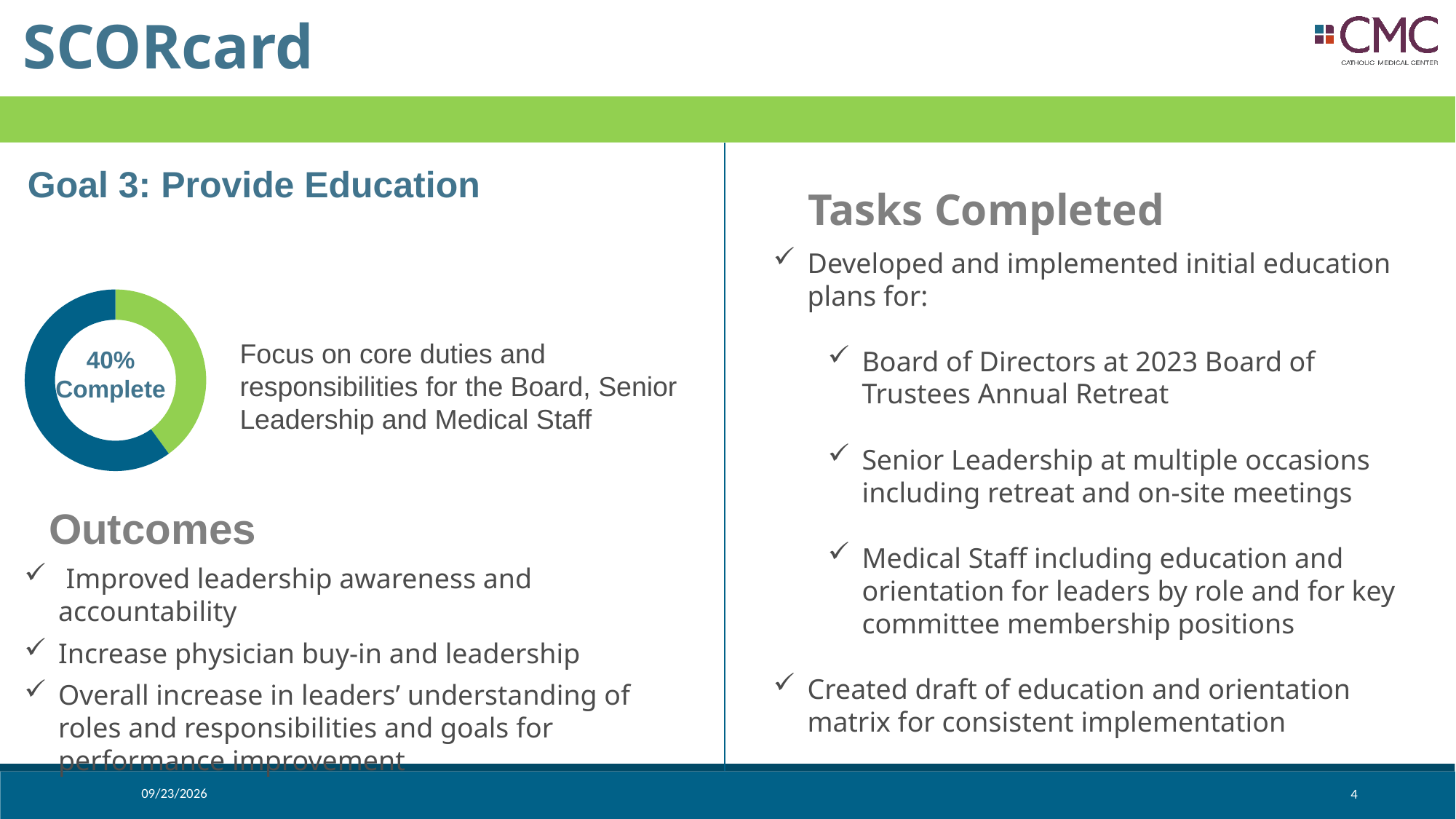
What share of the donut chart is not yet complete? 60% What share of the donut chart does the completed portion represent? 40% Which goal does the donut chart relate to? Goal 3: Provide Education What kind of chart is shown on the slide? Donut chart What text is printed in the centre of the donut chart? 40% Complete What percentage complete does the donut chart show for Goal 3? 40% Which segment of the donut chart is larger, the green one or the blue one? Blue What colour is the segment representing the completed portion of the donut chart? Green How many segments does the donut chart have? 2 Is the completed share shown in the donut chart greater or less than 50%? less